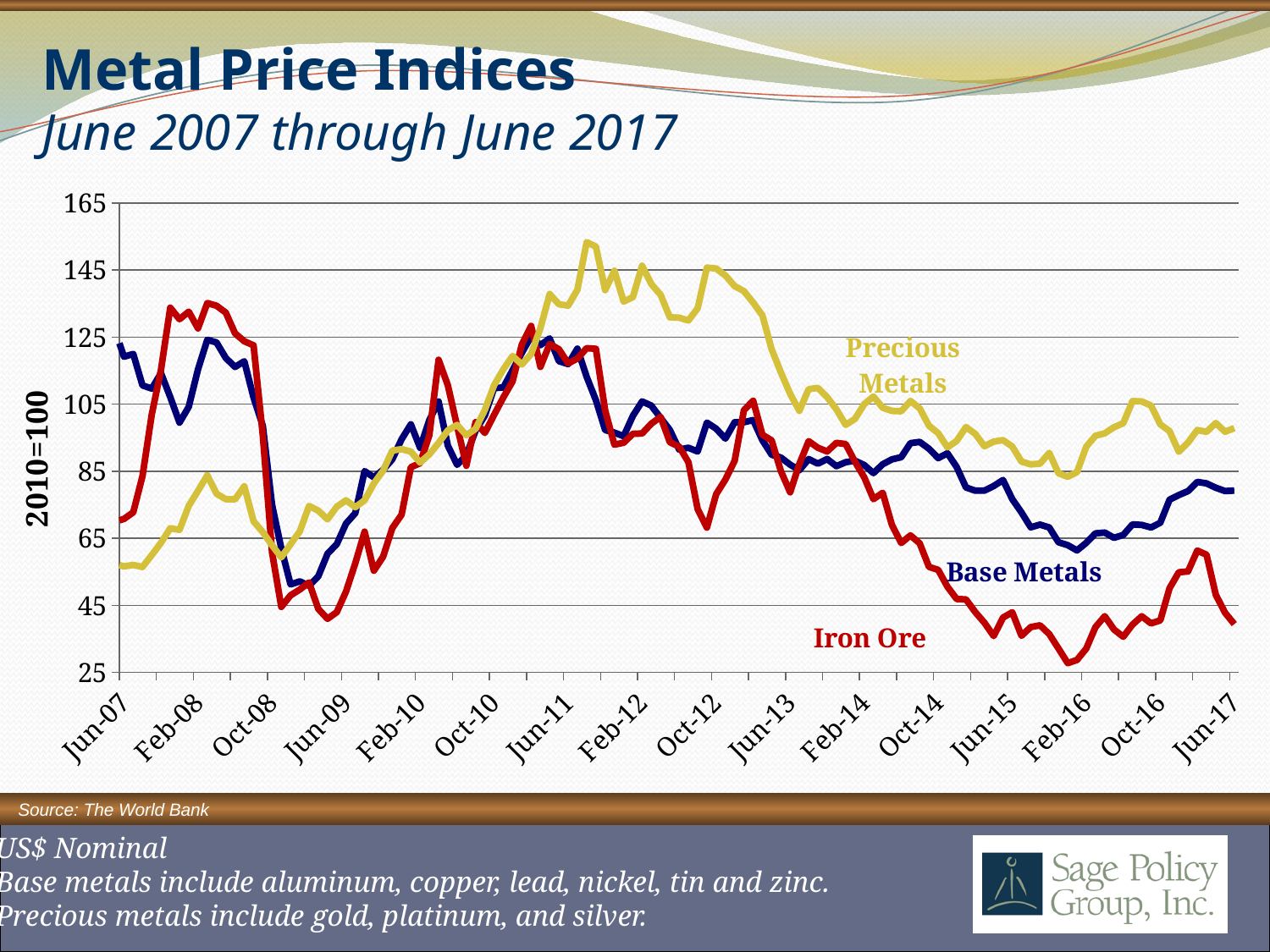
Does the Iron Ore series generally rise or fall between Jun-11 and Feb-16? Fall What is the label on the vertical axis of the chart? 2010=100 Which series falls to the lowest value anywhere on the chart? Iron Ore Is the value for Precious Metals at Jun-17 greater or less than 85? greater Which series reaches the highest value anywhere on the chart? Precious Metals At Feb-08, which is higher: Iron Ore or Precious Metals? Iron Ore What kind of chart is shown on the slide? Line chart Which three series are plotted on the chart? Precious Metals, Base Metals, Iron Ore Is the value for Precious Metals at Jun-07 greater or less than 65? less Is the value for Iron Ore at Feb-16 greater or less than 45? less How many series are plotted on the chart? 3 At Jun-17, which is higher: Base Metals or Iron Ore? Base Metals